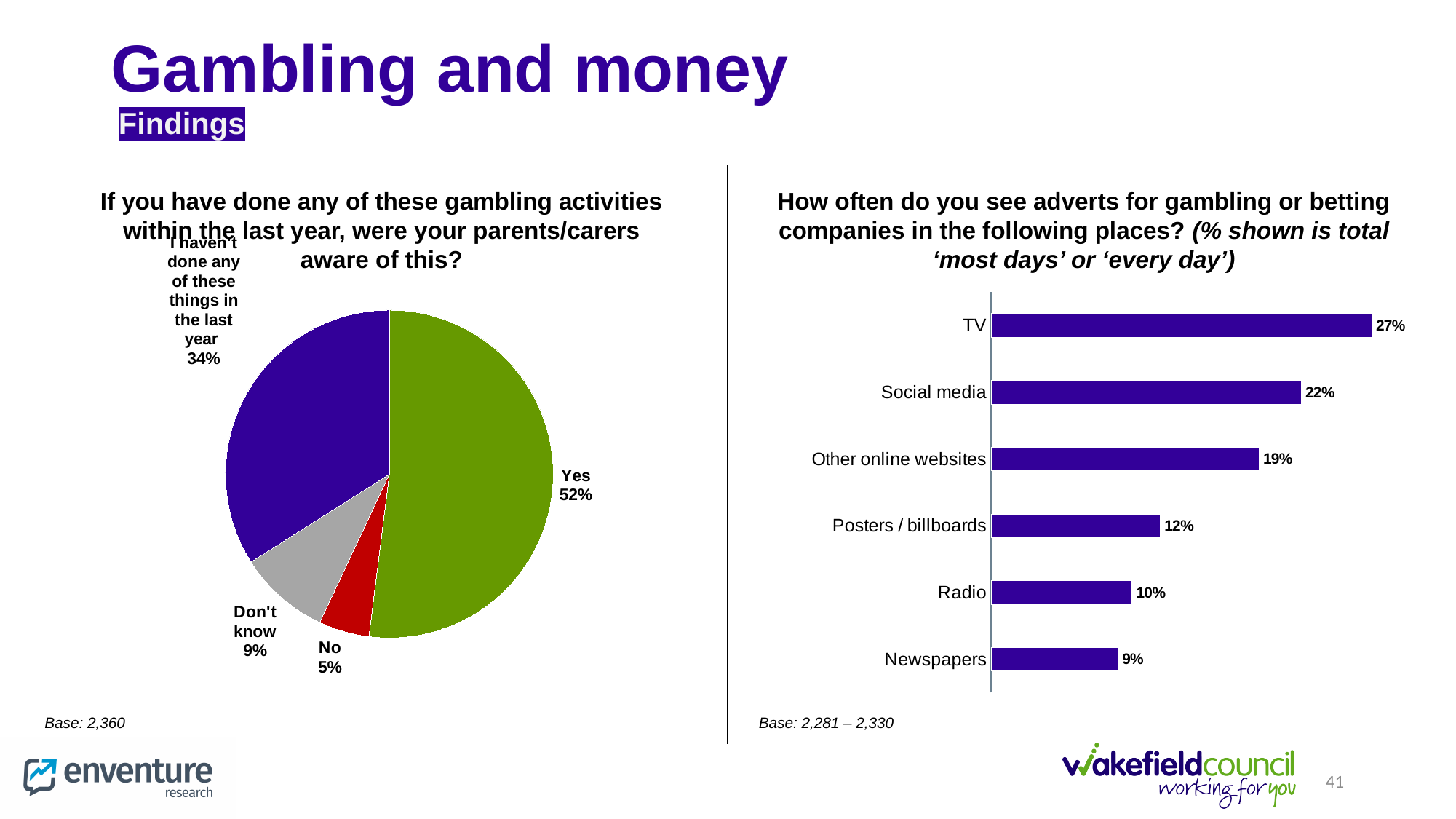
In the bar chart on the right, which place has the highest value? TV In the pie chart on the left, what is the difference between the 'Yes' share and the 'I haven't done any of these things in the last year' share? 18% In the bar chart on the right, how many places are listed? 6 In the bar chart on the right, which place has the lowest value? Newspapers In the bar chart on the right, what is the value for Social media? 22% In the pie chart on the left, how many slices are there? 4 In the pie chart on the left, what percentage answered 'Yes'? 52% In the pie chart on the left, which response has the smallest share? No What type of chart is shown on the right side of the slide? Bar chart In the pie chart on the left, what percentage answered 'Don't know'? 9% In the bar chart on the right, which is larger: Other online websites or Posters / billboards? Other online websites In the bar chart on the right, what is the difference between TV and Radio? 17%